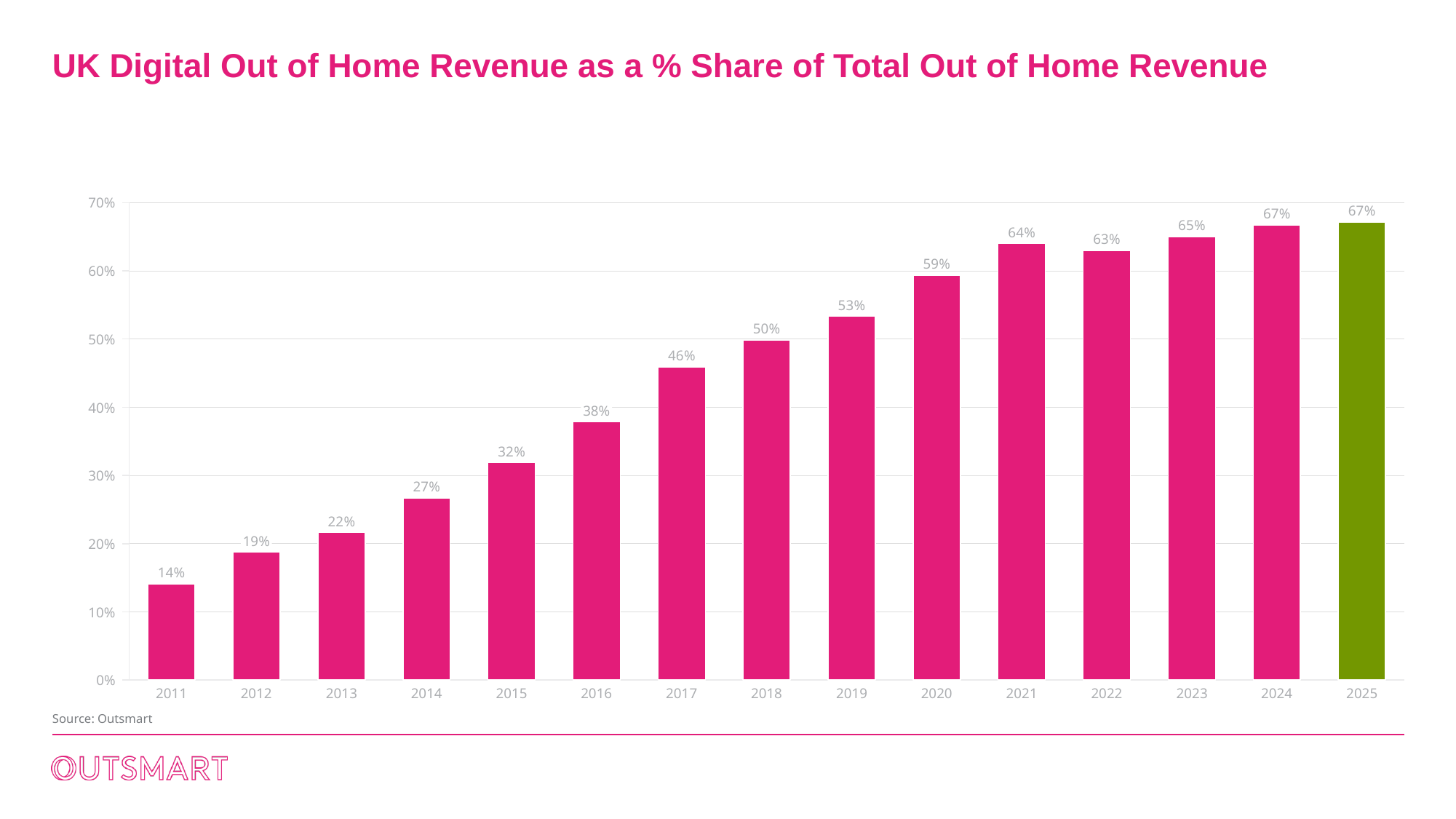
What is the difference in percentage points between the 2020 and 2011 values? 45 What is the digital share of out of home revenue in 2018? 50% Which is larger, the value for 2021 or the value for 2022? 2021 Which year has the lowest digital share of out of home revenue? 2011 Which year's bar is coloured green instead of pink? 2025 What kind of chart is shown on the slide? Bar chart How many years are shown on the x axis? 15 Do the values generally rise or fall from 2011 to 2025? Rise What is the digital share of out of home revenue in 2011? 14% What is the digital share of out of home revenue in 2022? 63% Is the value for 2017 greater or less than 40%? greater What is the difference in percentage points between the 2016 and 2015 values? 6